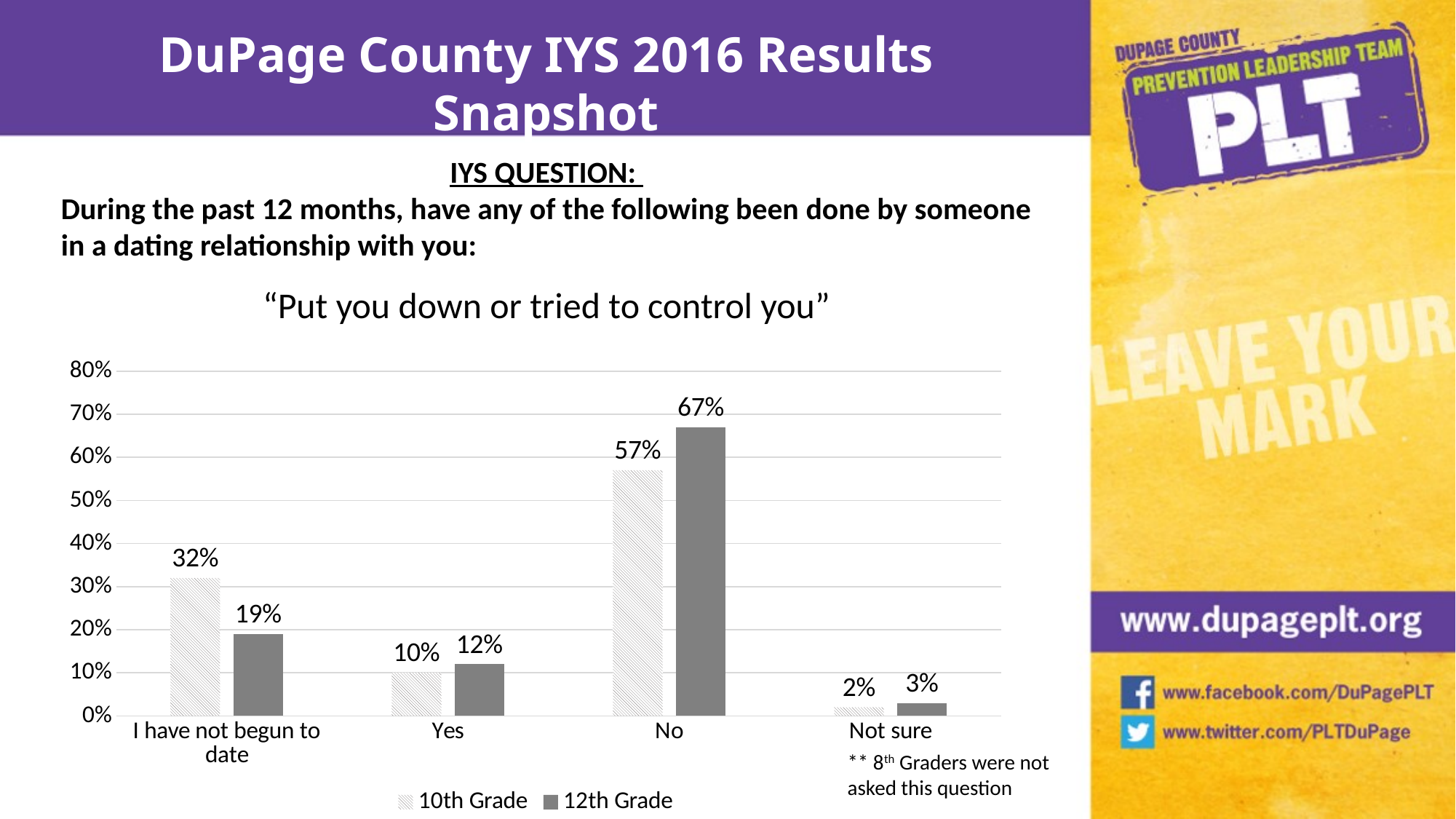
What is the value for 12th Grade in the "Yes" category? 12% Which category has the lowest value for 10th Grade? Not sure How many series does the legend list? 2 Which is larger in the "I have not begun to date" category: 10th Grade or 12th Grade? 10th Grade Which category has the highest value for 12th Grade? No What is the value for 10th Grade in the "I have not begun to date" category? 32% What is the value for 10th Grade in the "Not sure" category? 2% What is the title of the chart? "Put you down or tried to control you" How many categories are shown on the x axis? 4 What kind of chart is shown on the slide? Bar chart What is the difference between the 12th Grade and 10th Grade values in the "No" category? 10% What is the value for 12th Grade in the "No" category? 67%